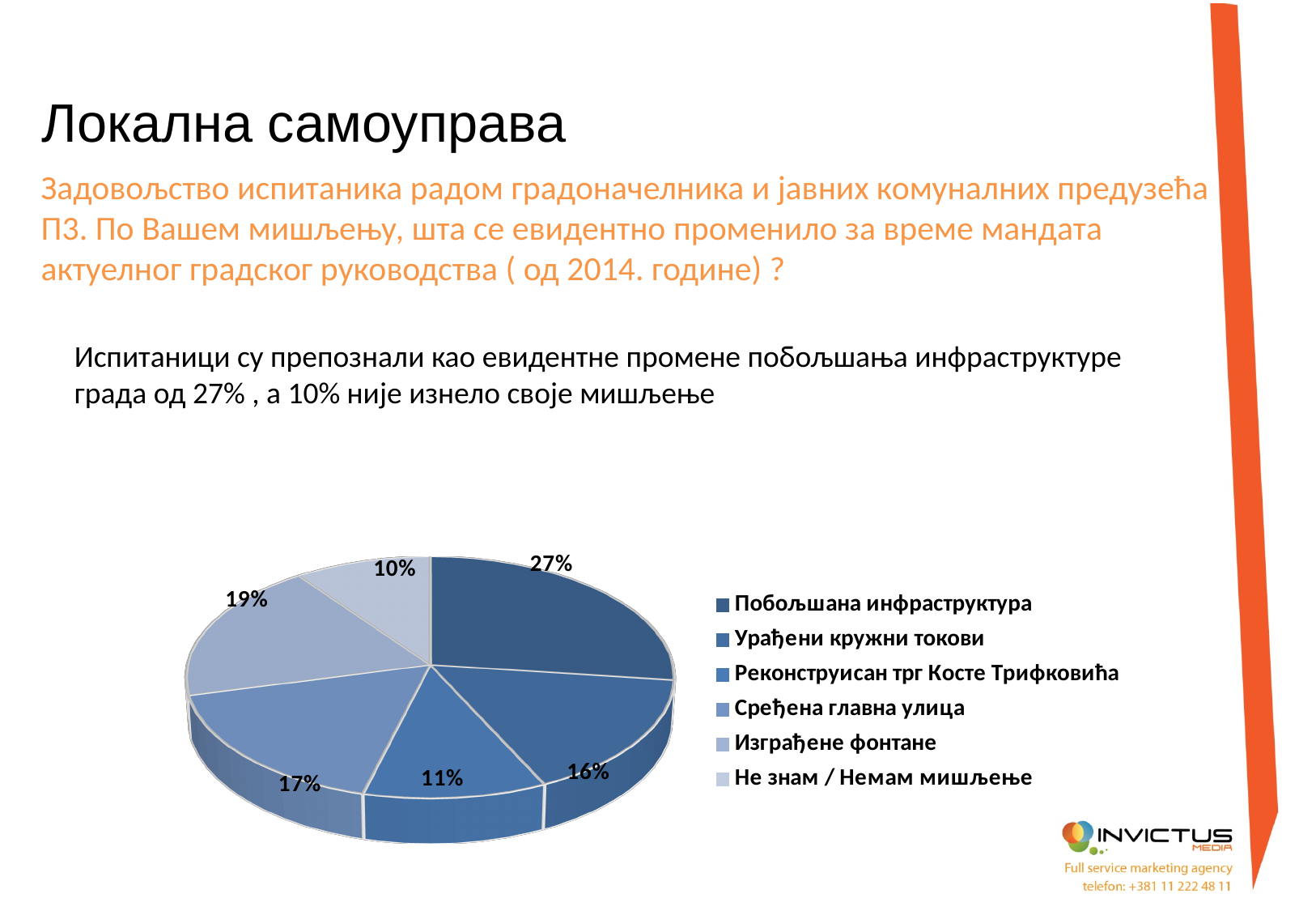
What share of respondents chose "Урађени кружни токови"? 16% What share of respondents chose "Изграђене фонтане"? 19% Which is larger: the share for "Сређена главна улица" or for "Урађени кружни токови"? Сређена главна улица What share of respondents chose "Побољшана инфраструктура"? 27% What share of respondents chose "Реконструисан трг Косте Трифковића"? 11% Which category has the largest share of the pie? Побољшана инфраструктура How many categories does the legend list? 6 Which category has the smallest share of the pie? Не знам / Немам мишљење What kind of chart is shown on the slide? pie chart What is the difference between the shares for "Побољшана инфраструктура" and "Изграђене фонтане"? 8% What share of respondents answered "Не знам / Немам мишљење"? 10% What share of respondents chose "Сређена главна улица"? 17%